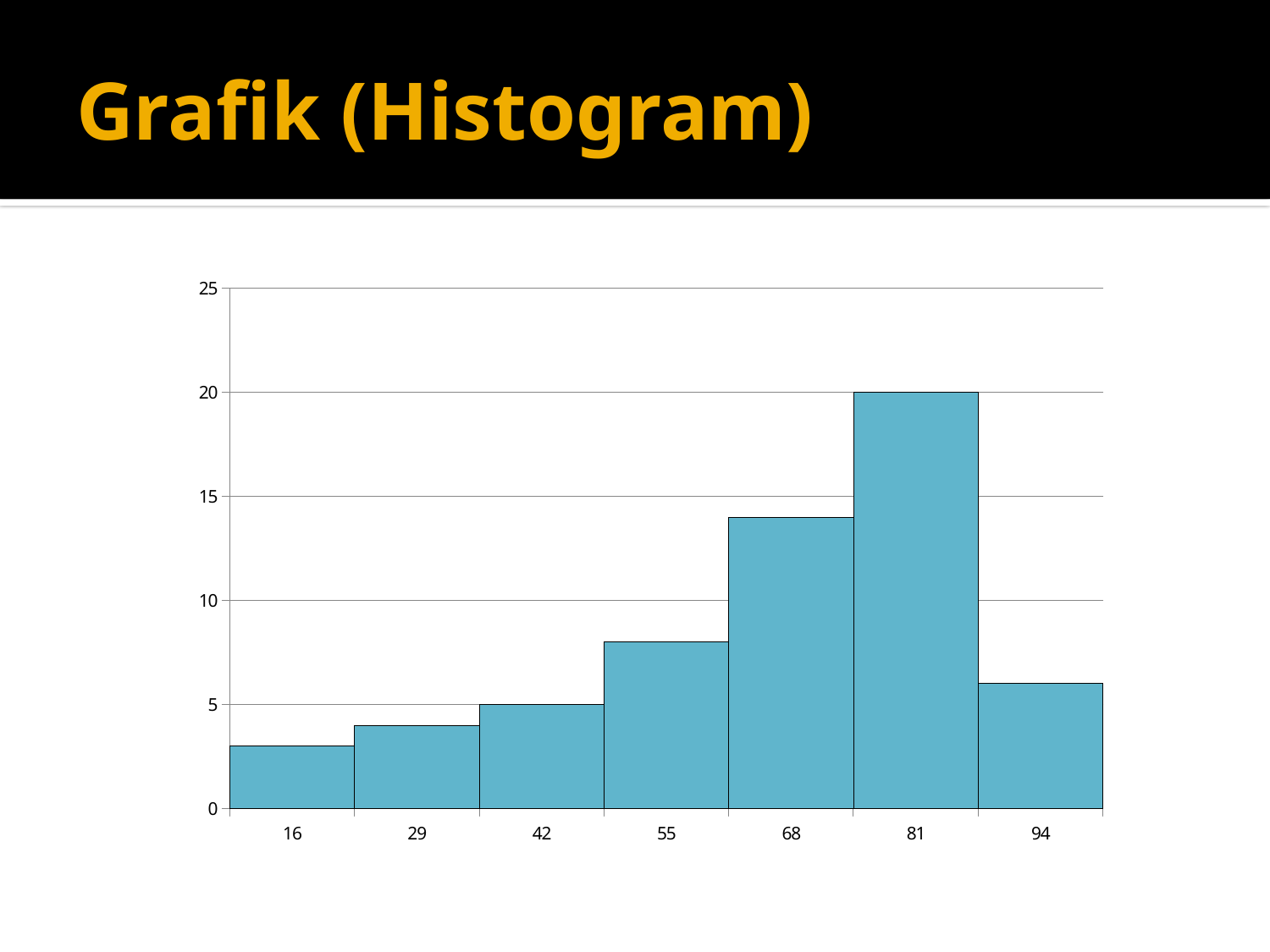
How many bars are plotted in the histogram? 7 What is the title of the slide containing the histogram? Grafik (Histogram) What is the value of the bar for 81? 20 Is the value for 68 greater or less than 10? greater Do the bar values rise or fall from 16 through 81 along the x axis? rise What kind of chart is shown on the slide? bar chart (histogram) What is the value of the bar for 42? 5 Which is larger, the bar for 68 or the bar for 55? 68 Which category has the highest bar? 81 What is the difference between the bar for 81 and the bar for 42? 15 Is the value for 16 greater or less than 5? less Which category has the lowest bar? 16